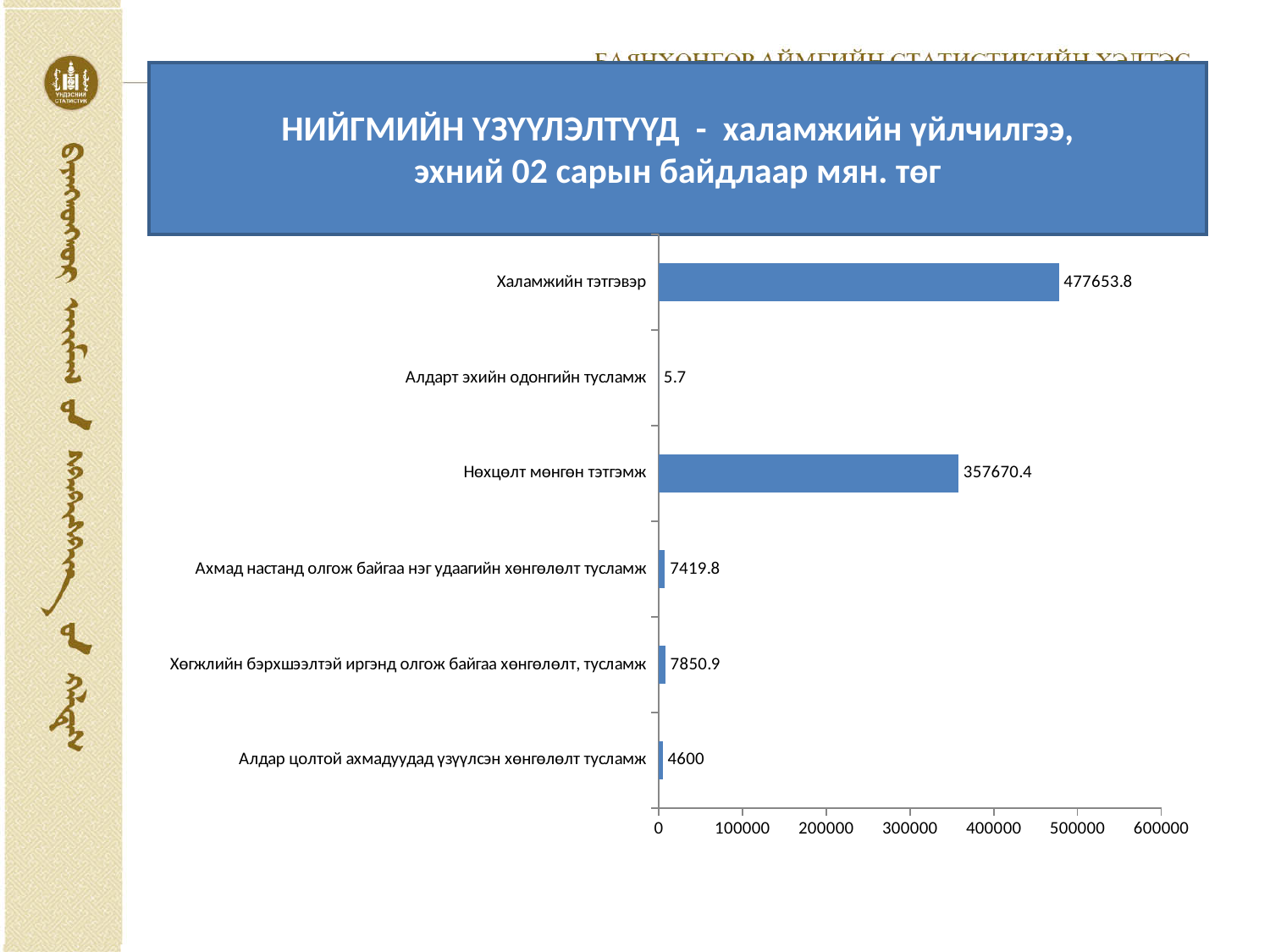
Is the value for Нөхцөлт мөнгөн тэтгэмж greater or less than 400000? less Which category has the lowest value? Алдарт эхийн одонгийн тусламж What is the difference between Хөгжлийн бэрхшээлтэй иргэнд олгож байгаа хөнгөлөлт, тусламж and Ахмад настанд олгож байгаа нэг удаагийн хөнгөлөлт тусламж? 431.1 What is the difference between Халамжийн тэтгэвэр and Нөхцөлт мөнгөн тэтгэмж? 119983.4 How many categories are shown in the chart? 6 What is the value for Алдар цолтой ахмадуудад үзүүлсэн хөнгөлөлт тусламж? 4600 Which category has the highest value? Халамжийн тэтгэвэр What kind of chart is shown on the slide? bar chart Which is larger: Хөгжлийн бэрхшээлтэй иргэнд олгож байгаа хөнгөлөлт, тусламж or Ахмад настанд олгож байгаа нэг удаагийн хөнгөлөлт тусламж? Хөгжлийн бэрхшээлтэй иргэнд олгож байгаа хөнгөлөлт, тусламж What is the value for Халамжийн тэтгэвэр? 477653.8 What is the value for Нөхцөлт мөнгөн тэтгэмж? 357670.4 What is the value for Алдарт эхийн одонгийн тусламж? 5.7